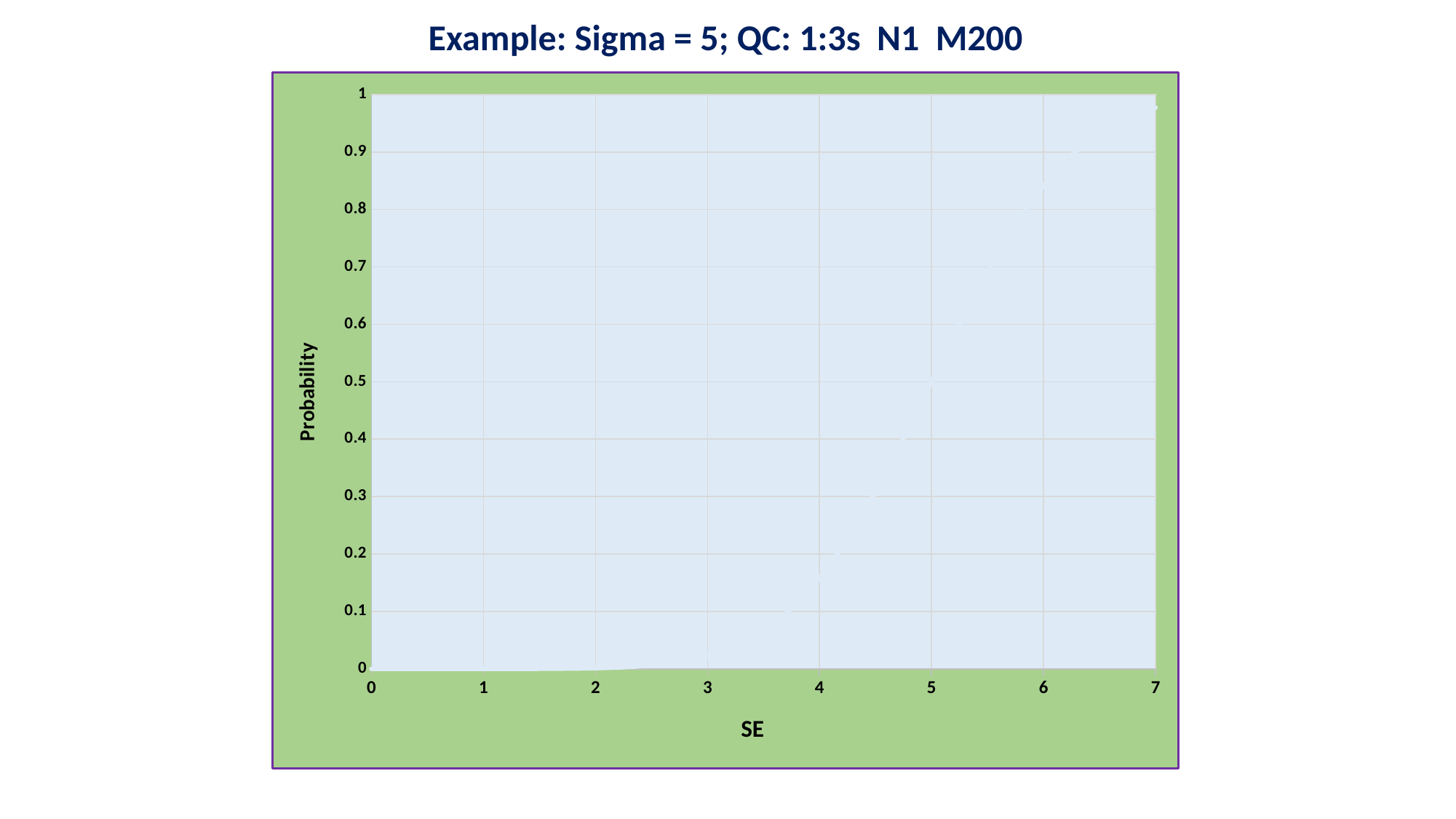
What is the label of the y axis? Probability What is the title of the chart? Example: Sigma = 5; QC: 1:3s N1 M200 Is the plotted value at SE = 1 greater or less than 0.1? less Is the plotted value at SE = 0 greater or less than 0.5? less Is the plotted value at SE = 2 greater or less than 0.1? less